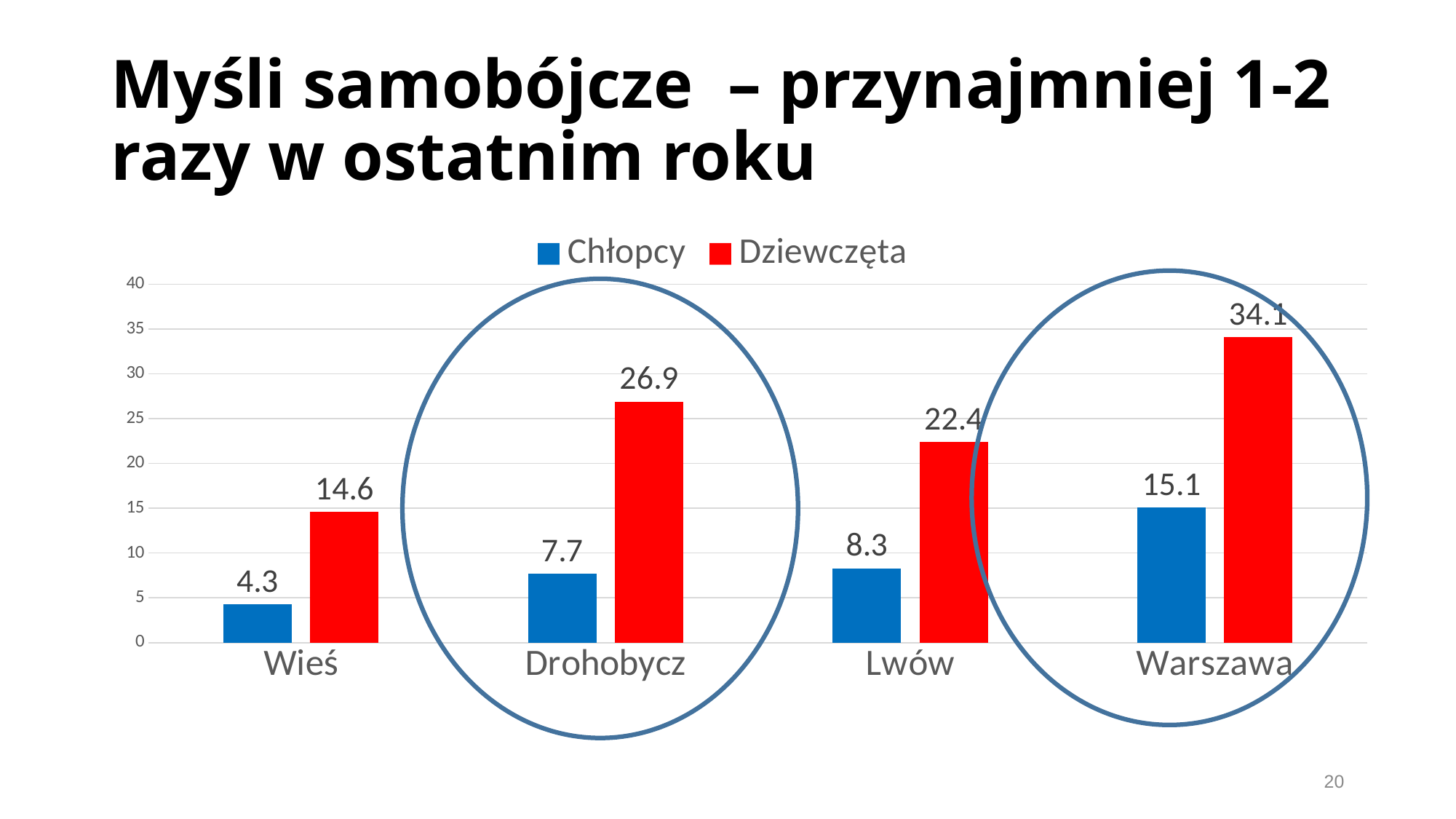
Is the value for Dziewczęta in Drohobycz greater or less than 25? greater What is the difference between Dziewczęta and Chłopcy in Drohobycz? 19.2 What is the value for Chłopcy in Wieś? 4.3 What is the value for Dziewczęta in Warszawa? 34.1 What kind of chart is shown on the slide? bar chart How many series does the legend list? 2 Which category has the highest value for Dziewczęta? Warszawa Which category has the lowest value for Chłopcy? Wieś How many categories are shown on the x axis? 4 Which is larger: Chłopcy in Warszawa or Chłopcy in Lwów? Chłopcy in Warszawa What is the value for Dziewczęta in Lwów? 22.4 Which colour represents Dziewczęta in the chart? red